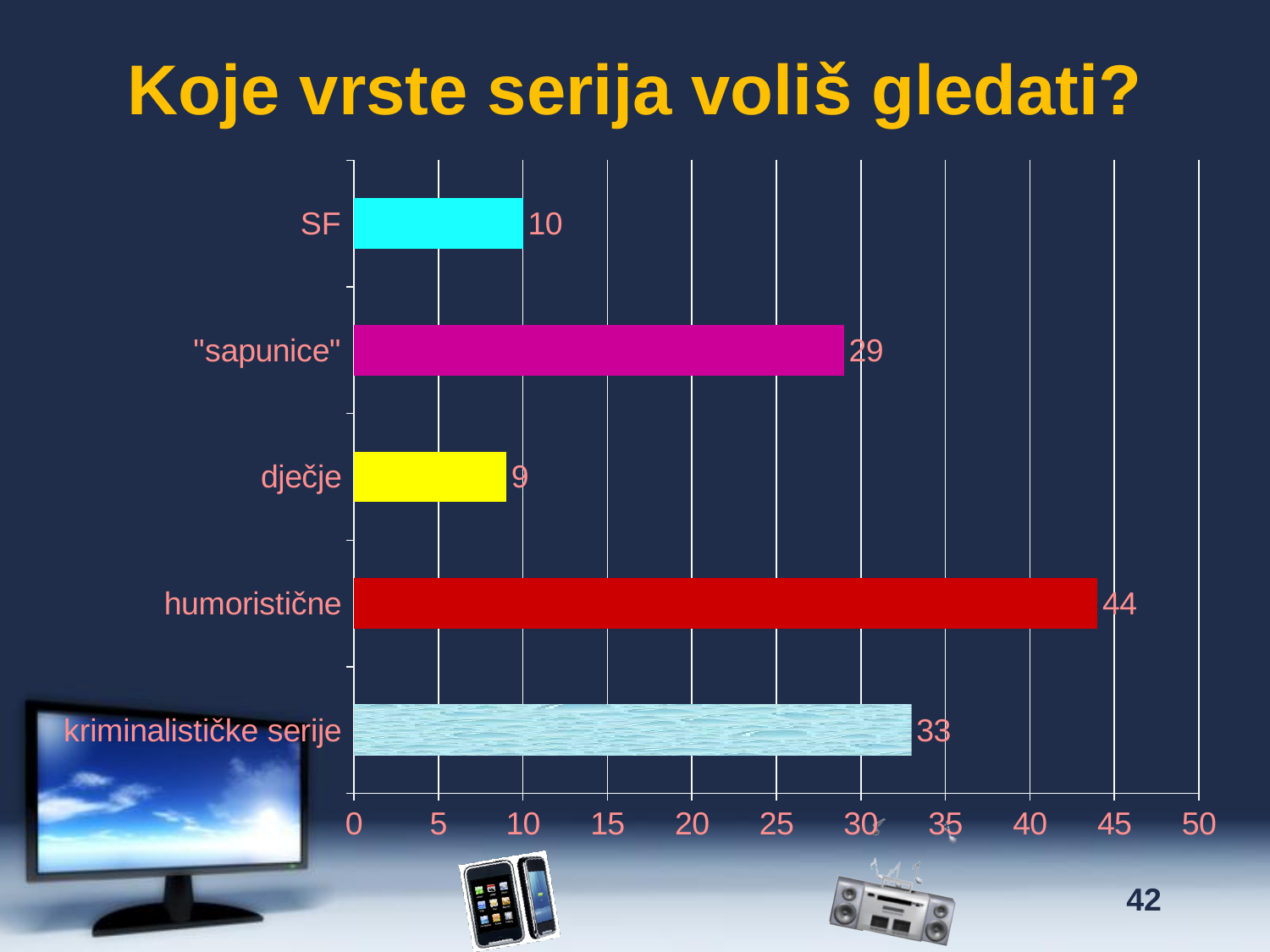
What is the title of the slide? Koje vrste serija voliš gledati? What is the difference between the values for humoristične and kriminalističke serije? 11 What is the value for humoristične? 44 What is the value for kriminalističke serije? 33 Which category has the highest value? humoristične What kind of chart is shown on the slide? bar chart Which category has the lowest value? dječje What is the difference between the values for "sapunice" and dječje? 20 What is the value for "sapunice"? 29 What is the value for SF? 10 How many categories are shown in the chart? 5 Which is larger, the value for "sapunice" or the value for kriminalističke serije? kriminalističke serije